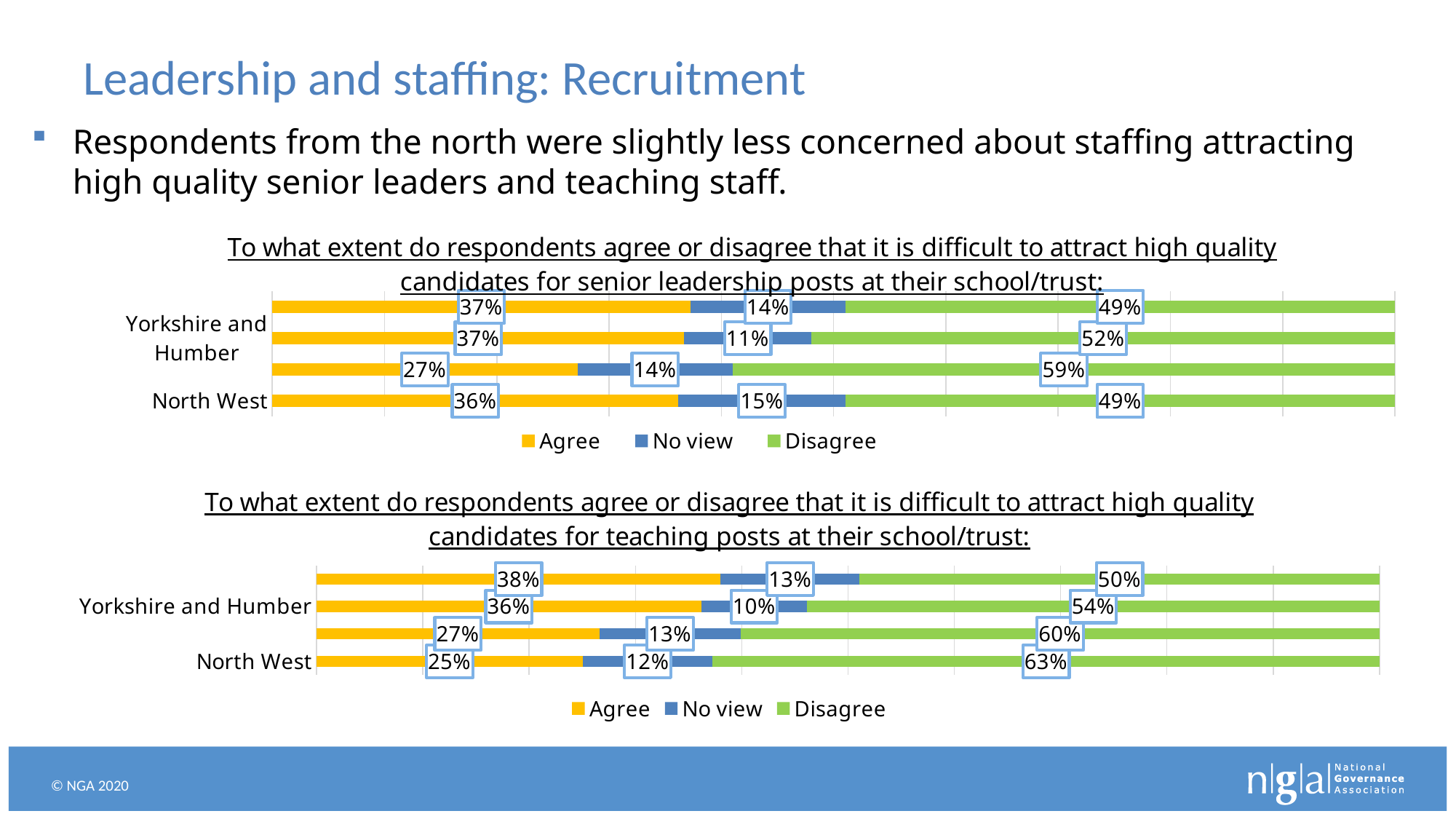
In the top chart (senior leadership posts), what percentage of North West respondents disagree? 49% In the top chart (senior leadership posts), what percentage of North West respondents agree? 36% In the bottom chart (teaching posts), what percentage of North West respondents agree? 25% How many bars are plotted in the top chart (senior leadership posts)? 4 In the bottom chart (teaching posts), what percentage of North West respondents disagree? 63% In the top chart (senior leadership posts), how many percentage points higher is the North West Disagree share than its Agree share? 13 percentage points How many series does the legend of the top chart list? 3 In the bottom chart (teaching posts), what percentage of Yorkshire and Humber respondents disagree? 54% In the bottom chart (teaching posts), what percentage of North West respondents have no view? 12% What kind of chart is the bottom chart (teaching posts)? Stacked bar chart In the bottom chart (teaching posts), for North West, which is larger: the Agree share or the Disagree share? Disagree In the top chart (senior leadership posts), what percentage of North West respondents have no view? 15%